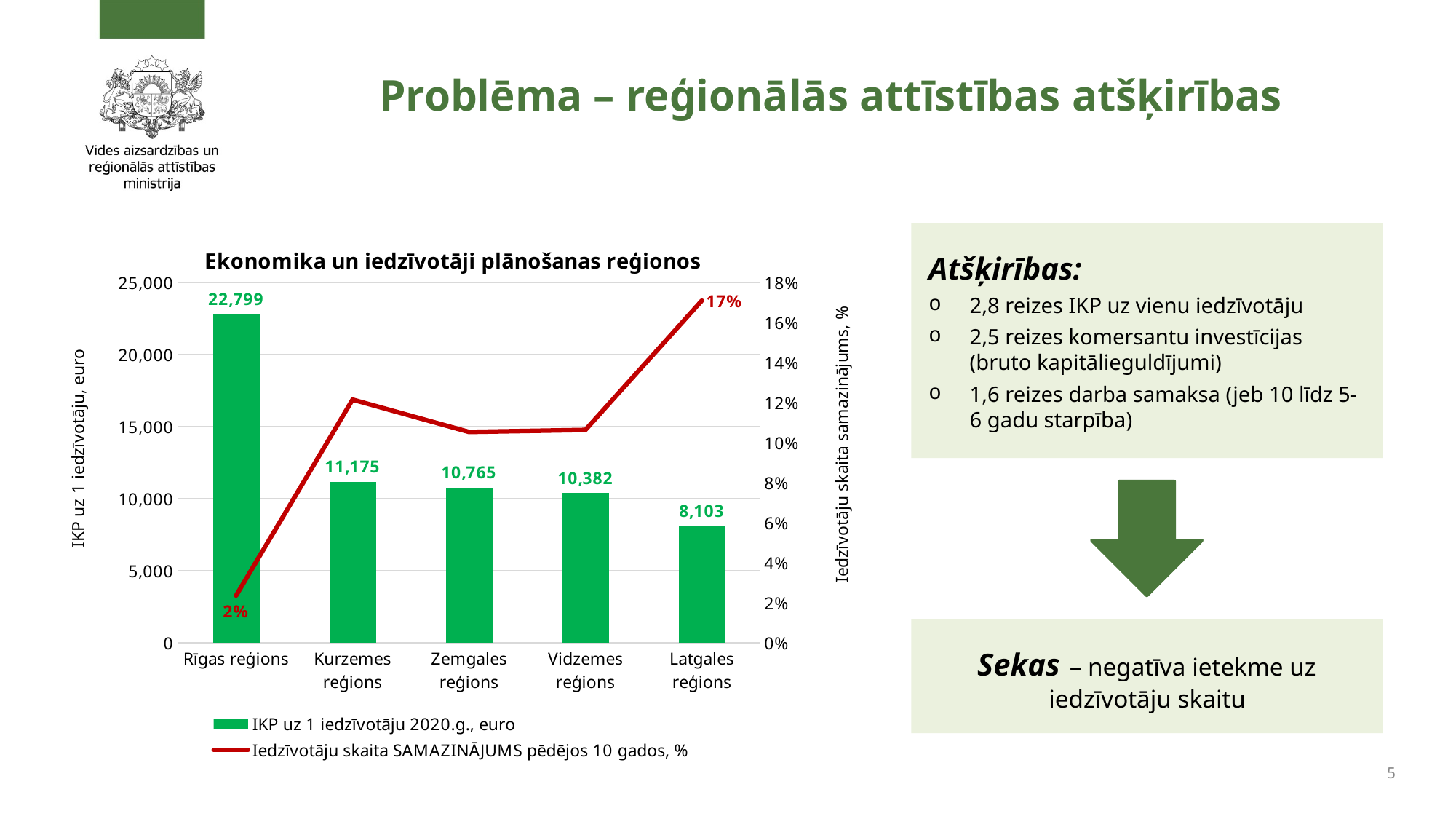
Which region has the highest IKP uz 1 iedzīvotāju 2020.g., euro? Rīgas reģions What is the title of the chart? Ekonomika un iedzīvotāji plānošanas reģionos What is the value of IKP uz 1 iedzīvotāju 2020.g., euro for Latgales reģions? 8,103 How many series does the chart legend list? 2 What is the Iedzīvotāju skaita SAMAZINĀJUMS pēdējos 10 gados, % value for Latgales reģions? 17% Which region has the lowest IKP uz 1 iedzīvotāju 2020.g., euro? Latgales reģions Which has a larger IKP uz 1 iedzīvotāju 2020.g., euro: Vidzemes reģions or Latgales reģions? Vidzemes reģions What is the value of IKP uz 1 iedzīvotāju 2020.g., euro for Rīgas reģions? 22,799 What kind of chart is used to show IKP uz 1 iedzīvotāju 2020.g., euro? Bar chart What is the difference in IKP uz 1 iedzīvotāju 2020.g., euro between Kurzemes reģions and Zemgales reģions? 410 How many regions are shown on the x axis of the chart? 5 Is the Iedzīvotāju skaita SAMAZINĀJUMS pēdējos 10 gados, % value for Kurzemes reģions greater or less than 10%? greater